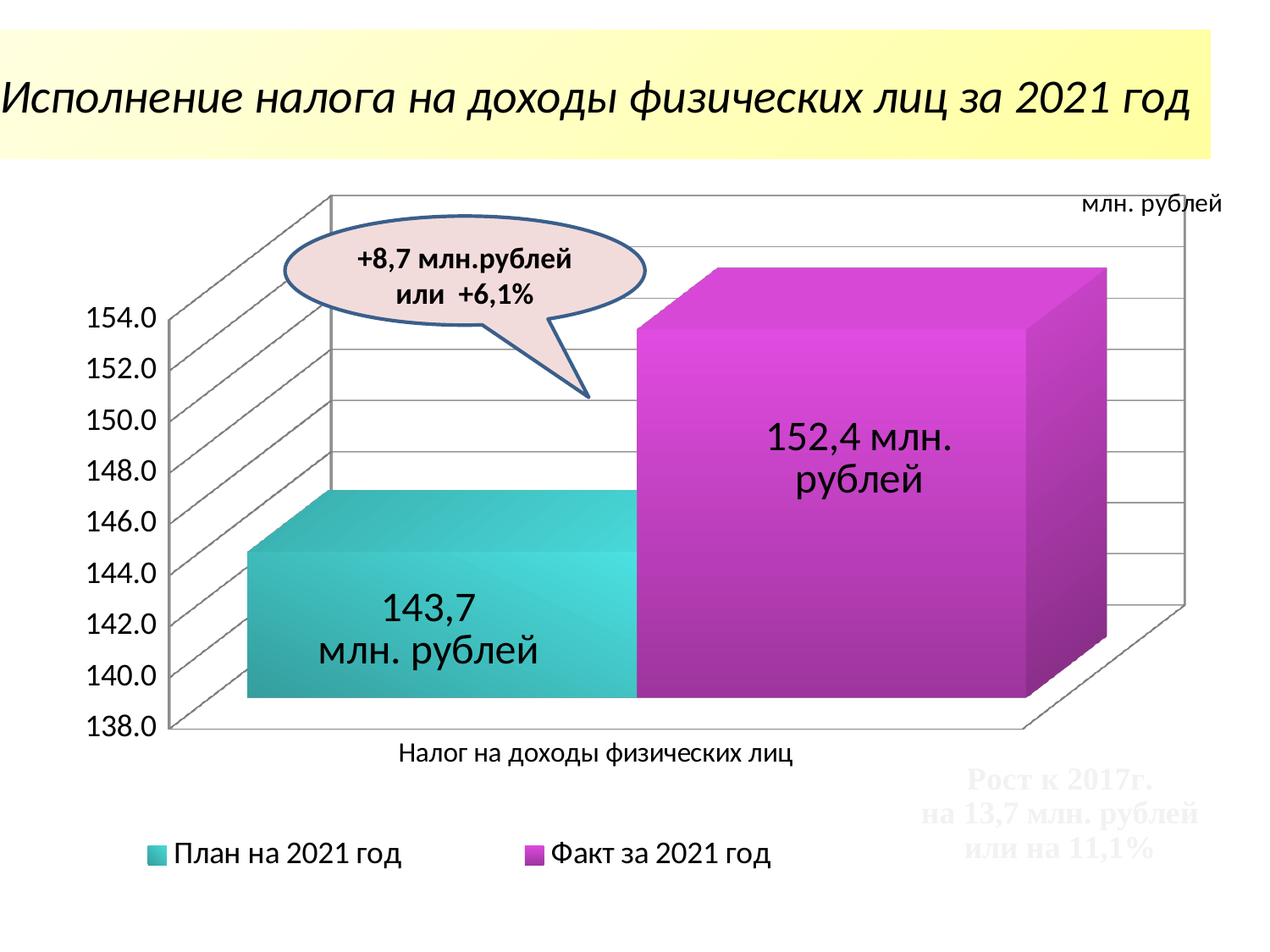
What kind of chart is shown on the slide? bar chart What is the value for План на 2021 год? 143,7 млн. рублей What is the difference between Факт за 2021 год and План на 2021 год? 8,7 млн. рублей Is the value for План на 2021 год greater or less than 144.0? less How many categories are shown on the x axis? 1 What is the value for Факт за 2021 год? 152,4 млн. рублей What percentage increase does the callout on the chart state? +6,1% Is the value for Факт за 2021 год greater or less than 150.0? greater Which series has the higher value, План на 2021 год or Факт за 2021 год? Факт за 2021 год How many series does the legend list? 2 Which series has the lowest value? План на 2021 год What is the category label on the x axis? Налог на доходы физических лиц